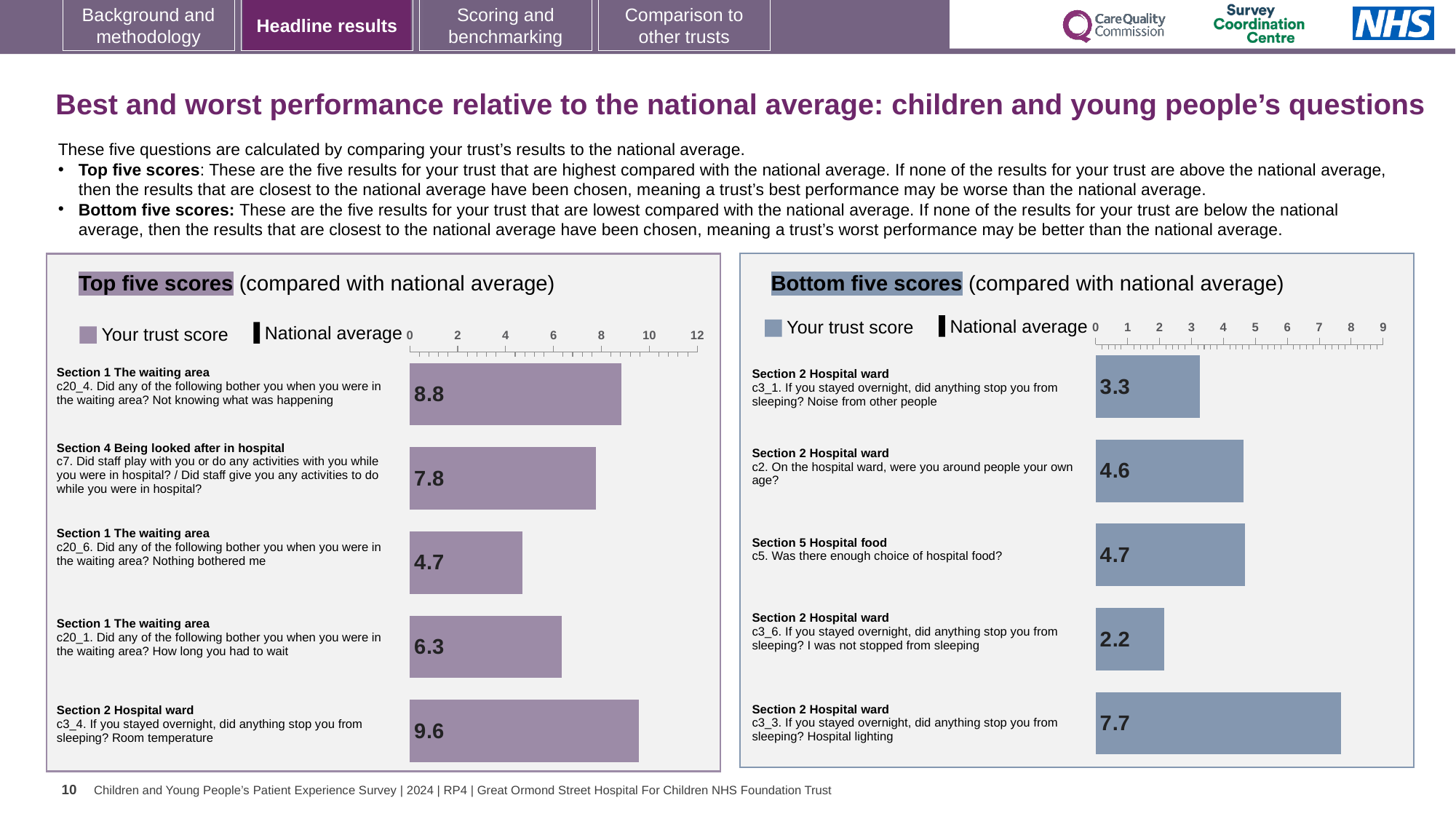
In the Top five scores chart, what is the trust score for c20_4 (Not knowing what was happening in the waiting area)? 8.8 In the Top five scores chart, which question has the lowest trust score? c20_6. Nothing bothered me In the Top five scores chart, which question has the highest trust score? c3_4. Room temperature In the Bottom five scores chart, which question has the highest trust score? c3_3. Hospital lighting In the Top five scores chart, what is the trust score for c3_4 (Room temperature stopping you from sleeping)? 9.6 In the Bottom five scores chart, what is the difference between the trust scores for c3_3 (7.7) and c3_1 (3.3)? 4.4 In the Bottom five scores chart, what is the trust score for c5 (enough choice of hospital food)? 4.7 In the Bottom five scores chart, which question has the lowest trust score? c3_6. I was not stopped from sleeping How many bars are shown in the Bottom five scores chart? 5 In the Bottom five scores chart, what is the trust score for c3_6 (I was not stopped from sleeping)? 2.2 In the Top five scores chart, which has the larger trust score: c7 (staff play/activities) or c20_6 (Nothing bothered me)? c7 (staff play/activities) In the Top five scores chart, what is the difference between the trust scores for c20_4 (8.8) and c20_1 (6.3)? 2.5